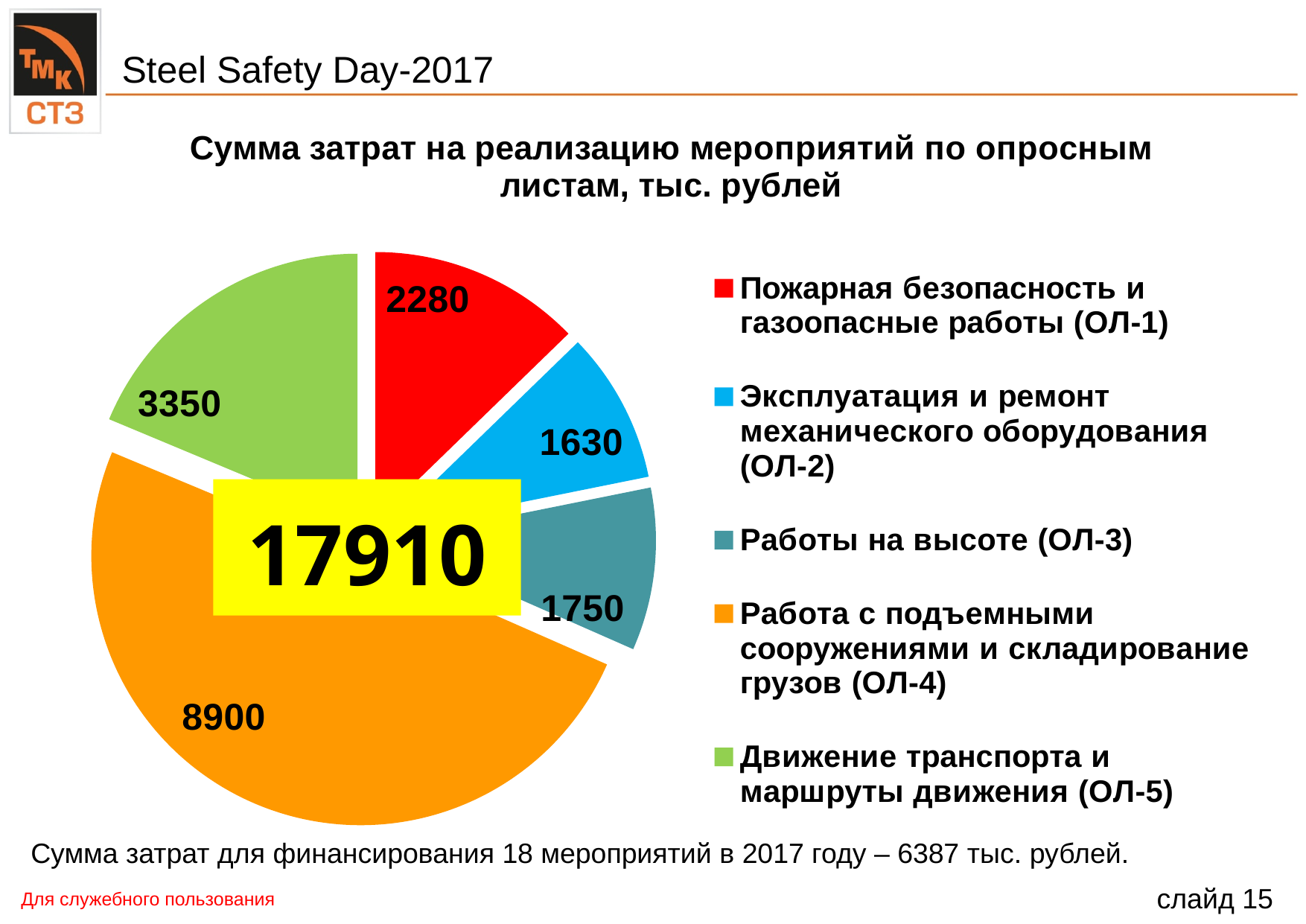
Which is larger, the value for ОЛ-1 or the value for ОЛ-3? ОЛ-1 What is the value for Работа с подъемными сооружениями и складирование грузов (ОЛ-4)? 8900 What total is shown in the centre of the pie chart? 17910 Which category has the largest slice of the pie? Работа с подъемными сооружениями и складирование грузов (ОЛ-4) How many categories does the pie chart have? 5 What is the difference between the values for ОЛ-4 and ОЛ-5? 5550 What is the value for Эксплуатация и ремонт механического оборудования (ОЛ-2)? 1630 What is the value for Работы на высоте (ОЛ-3)? 1750 What is the value for Движение транспорта и маршруты движения (ОЛ-5)? 3350 Which category has the smallest slice of the pie? Эксплуатация и ремонт механического оборудования (ОЛ-2) What is the value for Пожарная безопасность и газоопасные работы (ОЛ-1)? 2280 What type of chart is shown on the slide? pie chart